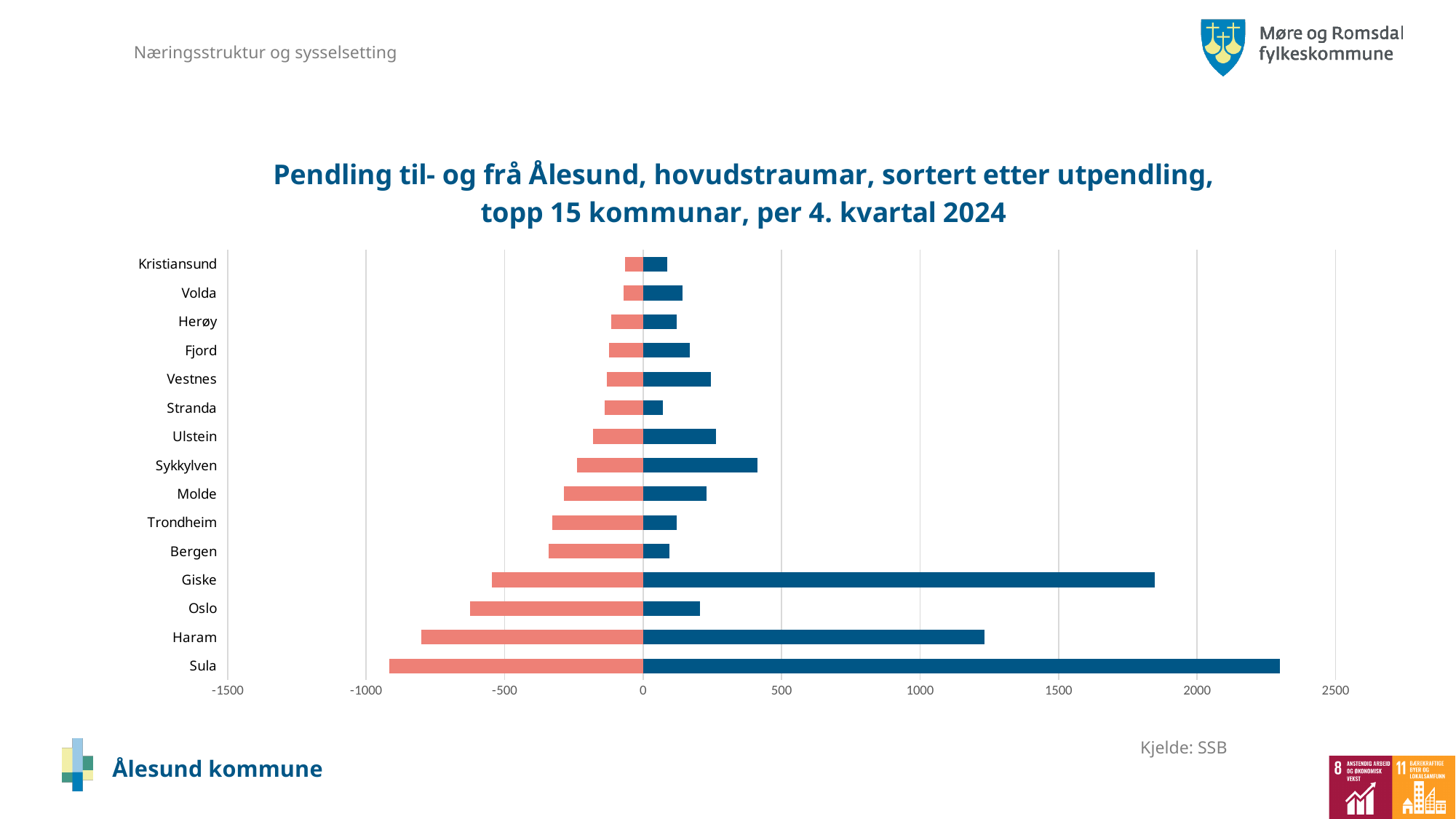
Which has the larger blue bar, Sykkylven or Molde? Sykkylven Is the blue bar value for Giske greater or less than 1500? greater What is the title of the chart? Pendling til- og frå Ålesund, hovudstraumar, sortert etter utpendling, topp 15 kommunar, per 4. kvartal 2024 Is the blue bar value for Oslo greater or less than 500? less Which municipality has the longest red bar (largest negative value)? Sula What kind of chart is shown on the slide? bar chart Which municipality has the longest blue bar (highest positive value)? Sula Which has the larger blue bar, Sula or Giske? Sula Is the blue bar value for Haram greater or less than 1000? greater How many municipalities (categories) are plotted on the chart? 15